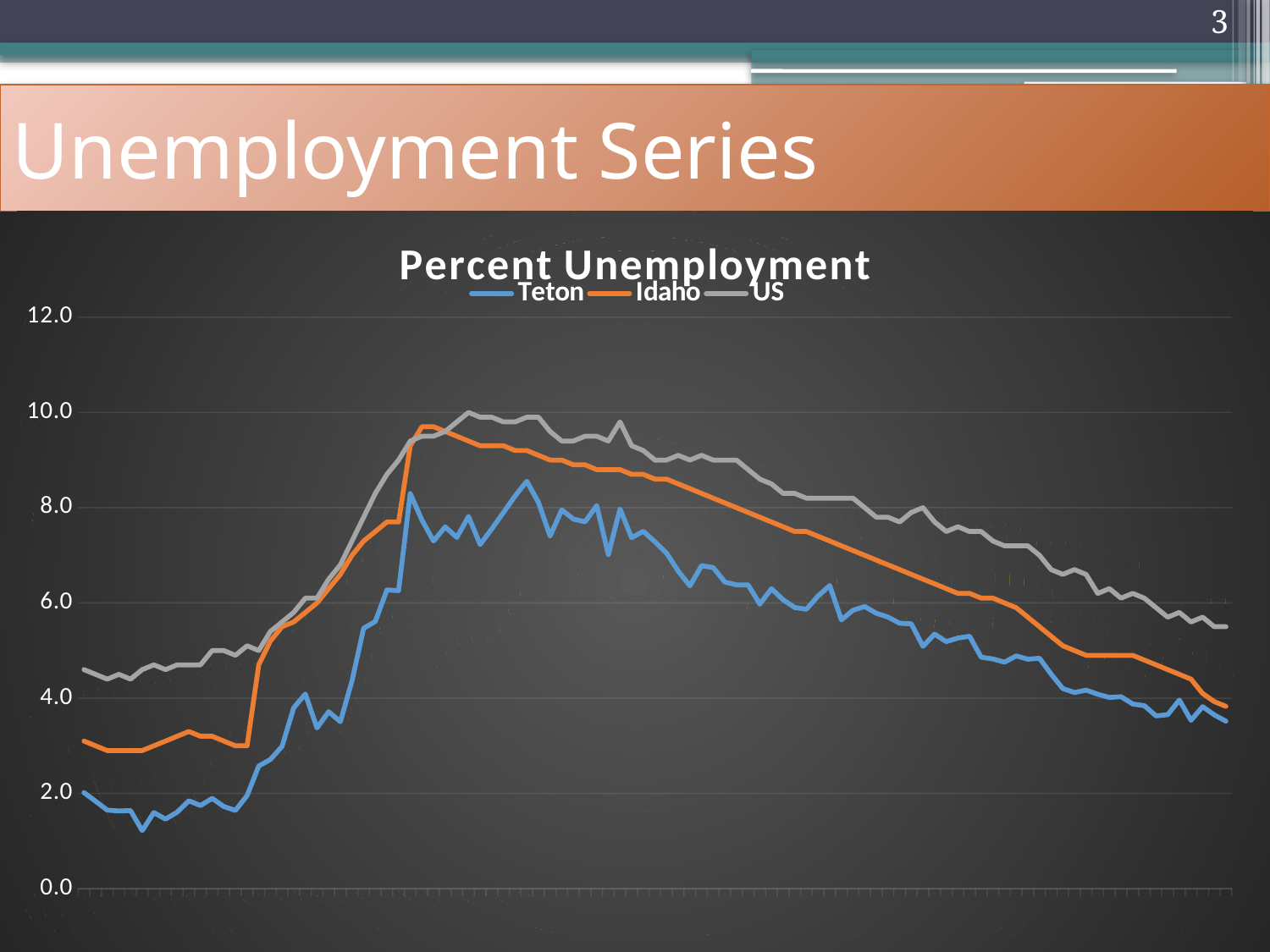
Is the value for Idaho at the left end of the chart greater or less than 2.0? greater Which series has the highest value at the right end of the chart? US Which series has the lowest values at the left end of the chart? Teton What is the title of the chart? Percent Unemployment How many series does the legend of the Percent Unemployment chart list? 3 Is the peak value for Teton greater or less than 8.0? greater What kind of chart is shown on the slide? line chart Is the value for Teton at the right end of the chart greater or less than 4.0? less Which colour is used for the Teton series in the chart? blue Do the values for Idaho rise or fall over the right half of the chart? fall